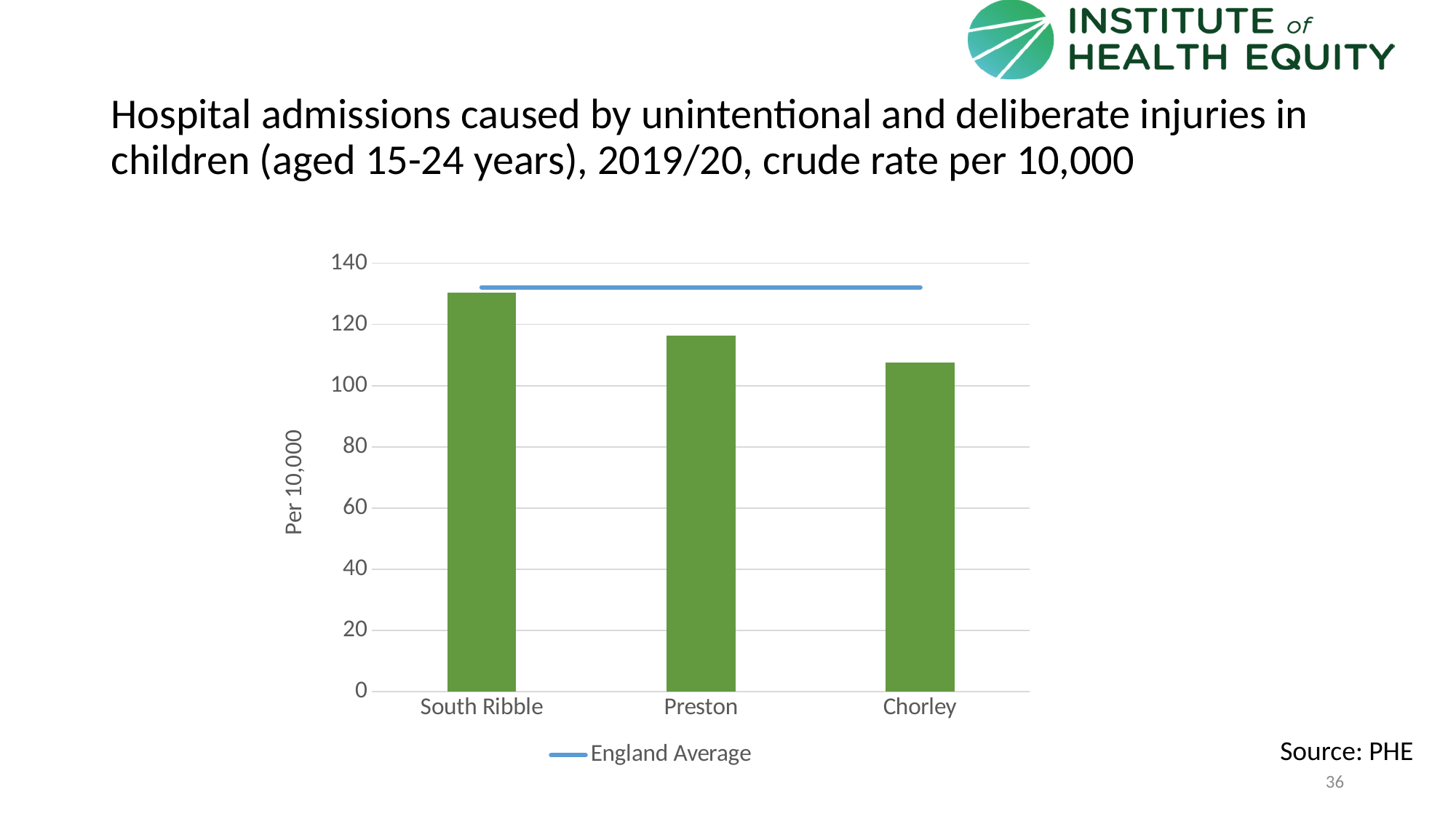
Do the bar values rise or fall from left to right across the chart? Fall What kind of chart is shown on the slide? Bar chart Which has the higher value, South Ribble or Preston? South Ribble Is the value for Chorley greater or less than 100? greater What does the horizontal blue line on the chart represent? England Average How many areas (bars) are plotted on the chart? 3 How many entries does the chart's legend list? 1 Which area has the lowest hospital admission rate on the chart? Chorley Is the value for Preston greater or less than 120? less Which has the higher value, Preston or Chorley? Preston Is the value for South Ribble greater or less than 120? greater Which area has the highest hospital admission rate on the chart? South Ribble